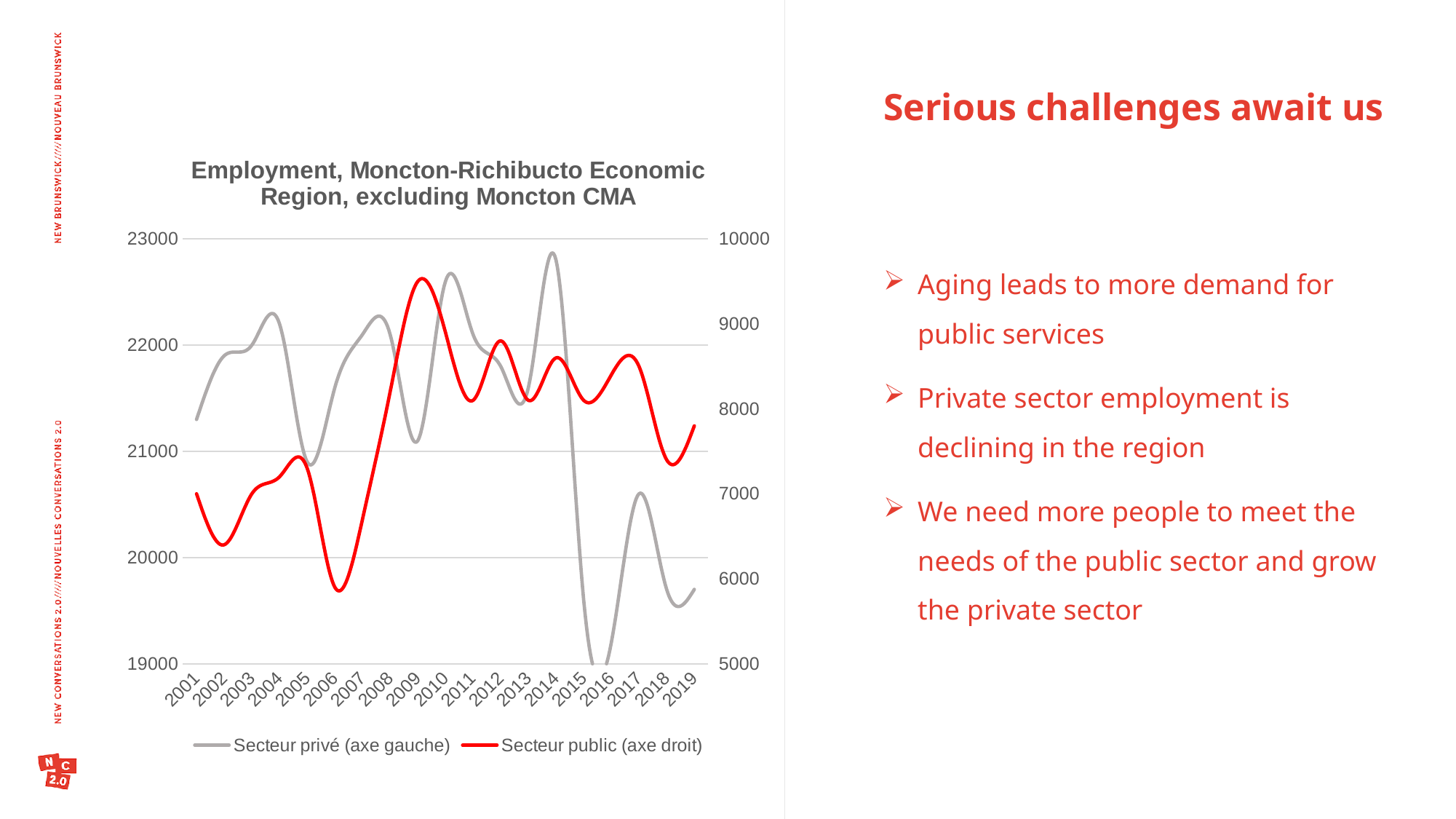
In which year does the Secteur privé series reach its highest value? 2014 In which year does the Secteur public series reach its highest value? 2009 Does the Secteur privé series rise or fall between 2014 and 2016? fall In which year does the Secteur privé series reach its lowest value? 2016 Is the Secteur public value for 2009 greater or less than 9000? greater Is the Secteur privé value for 2016 greater or less than 20000? less Which series is plotted against the right axis according to the legend? Secteur public (axe droit) What is the title of the chart? Employment, Moncton-Richibucto Economic Region, excluding Moncton CMA How many years are shown along the x axis of the chart? 19 What kind of chart is shown on the slide? Line chart In which year does the Secteur public series reach its lowest value? 2006 How many series does the chart's legend list? 2